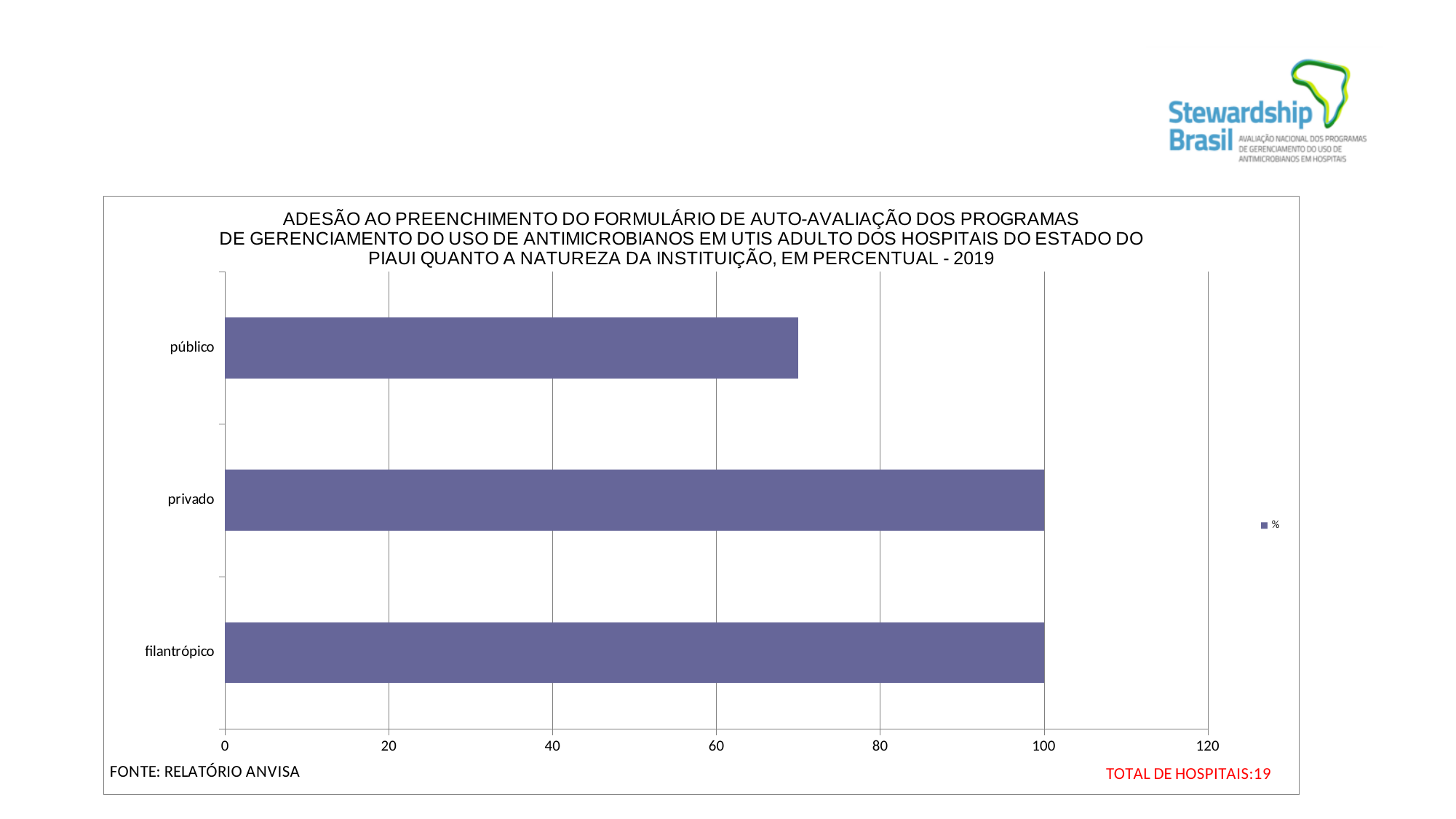
What is the legend entry shown on the chart? % Is the value for público greater or less than 60? greater How many series does the legend list? 1 What kind of chart is shown on the slide? bar chart Which is larger, the value for privado or the value for público? privado Which category has the lowest value? público What total number of hospitals is stated on the slide? 19 What is the value for privado? 100 How many categories are plotted on the chart? 3 What is the value for filantrópico? 100 Is the value for público greater or less than 80? less Which is larger, the value for filantrópico or the value for público? filantrópico